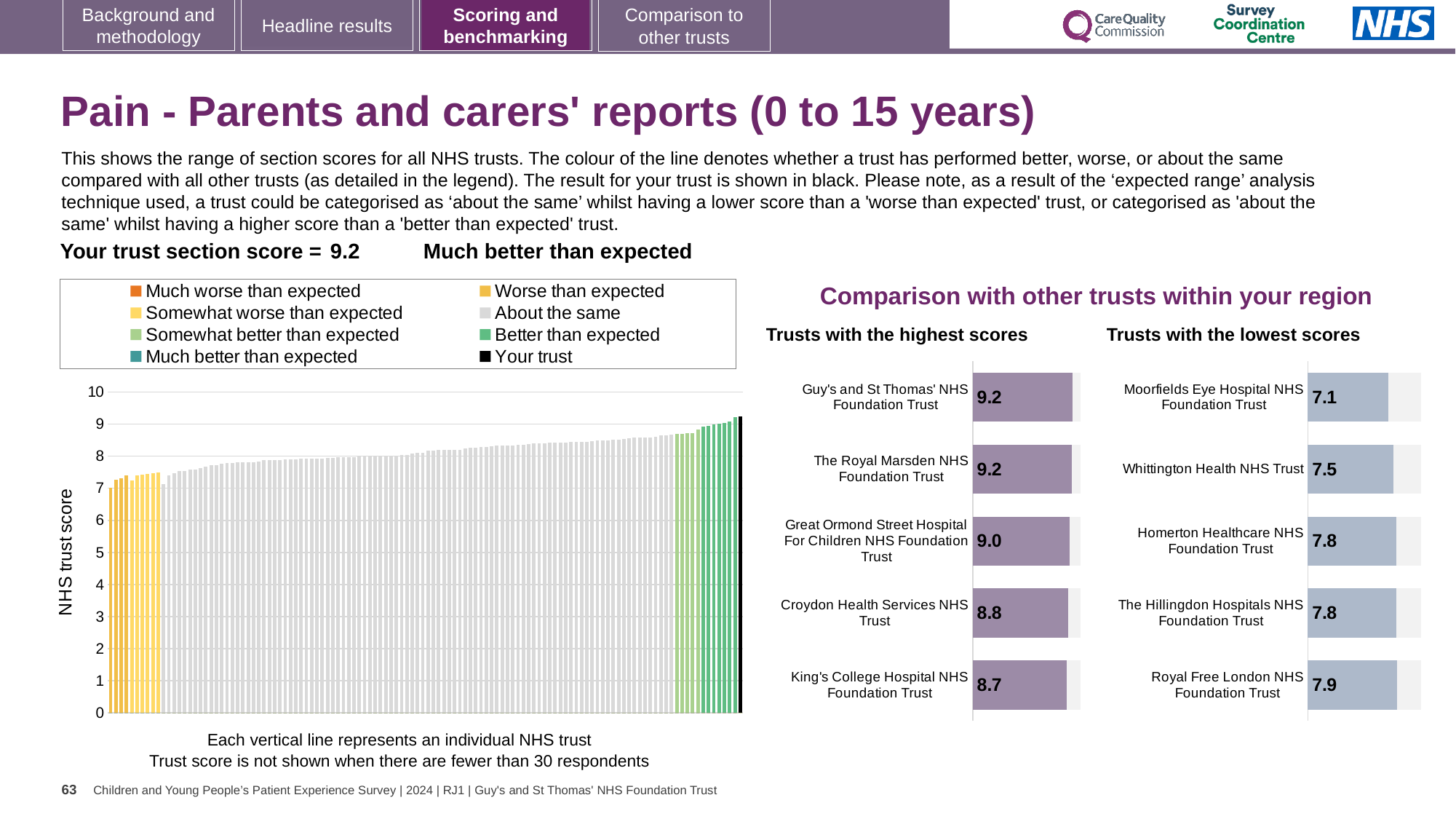
In the 'Trusts with the highest scores' chart, what is the score for Great Ormond Street Hospital For Children NHS Foundation Trust? 9.0 In the 'Trusts with the lowest scores' chart, what is the score for Whittington Health NHS Trust? 7.5 In the 'Trusts with the highest scores' chart, what is the difference between the scores of Guy's and St Thomas' NHS Foundation Trust and King's College Hospital NHS Foundation Trust? 0.5 In the 'Trusts with the lowest scores' chart, which trust has the lowest score? Moorfields Eye Hospital NHS Foundation Trust What is the y-axis label of the large chart on the left? NHS trust score Which has a higher score: Croydon Health Services NHS Trust in the highest scores chart or Whittington Health NHS Trust in the lowest scores chart? Croydon Health Services NHS Trust In the 'Trusts with the highest scores' chart, which trust has the lowest score? King's College Hospital NHS Foundation Trust In the large chart on the left showing all NHS trusts, do the bar values rise or fall from left to right? rise In the 'Trusts with the lowest scores' chart, which trust has the highest score? Royal Free London NHS Foundation Trust In the 'Trusts with the lowest scores' chart, what is the difference between the scores of Royal Free London NHS Foundation Trust and Moorfields Eye Hospital NHS Foundation Trust? 0.8 How many trusts are shown in the 'Trusts with the highest scores' chart? 5 How many entries does the legend above the large chart on the left list? 8